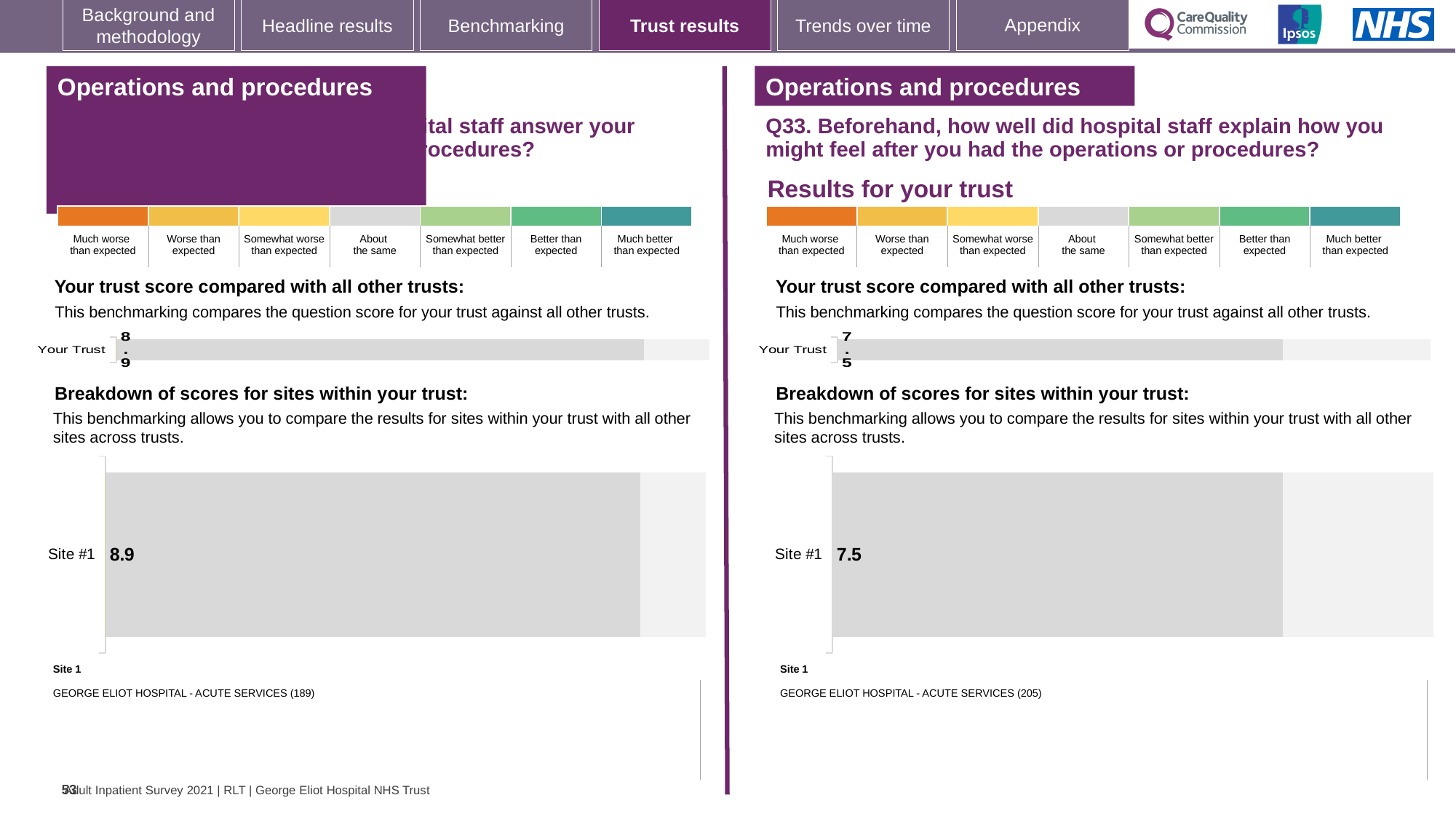
Which is larger: the Site #1 score on the left panel or the Site #1 score on the right panel (Q33)? Left panel (8.9) What is the difference between the Site #1 score on the left panel and the Site #1 score on the right panel (Q33)? 1.4 On the right panel (Q33), what is the score shown for Site #1 in the 'Breakdown of scores for sites within your trust' chart? 7.5 On the right panel (Q33), which site name is listed as Site 1 below the chart? GEORGE ELIOT HOSPITAL - ACUTE SERVICES (205) How many sites are shown in the 'Breakdown of scores for sites within your trust' chart on the left panel? 1 On the left panel, what is the score shown for Site #1 in the 'Breakdown of scores for sites within your trust' chart? 8.9 On the right panel (Q33), is the Your Trust score the same as the Site #1 score? Yes, both 7.5 On the right panel (Q33), what is the score shown for Your Trust in the 'Your trust score compared with all other trusts' chart? 7.5 On the left panel, what is the score shown for Your Trust in the 'Your trust score compared with all other trusts' chart? 8.9 How many sites are shown in the 'Breakdown of scores for sites within your trust' chart on the right panel (Q33)? 1 What type of chart is used to show the Site #1 score on the right panel (Q33)? Bar chart On the left panel, what number appears in brackets after the Site 1 name 'GEORGE ELIOT HOSPITAL - ACUTE SERVICES'? 189